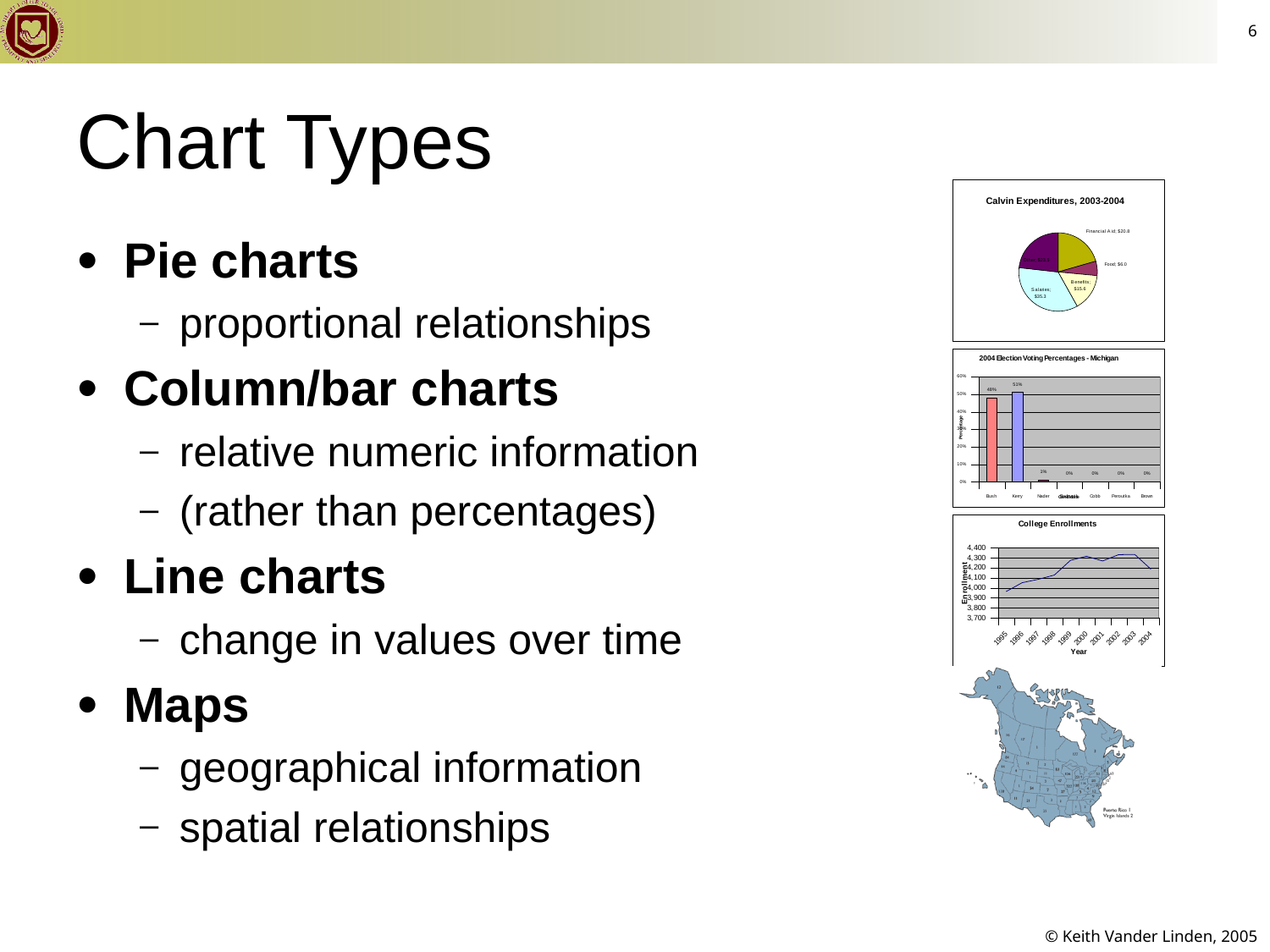
In the 2004 Election Voting Percentages - Michigan chart, what percentage is shown for Bush? 48% In the 2004 Election Voting Percentages - Michigan chart, what is the difference between Kerry's and Bush's percentages? 3% In the Calvin Expenditures, 2003-2004 pie chart, what is the value shown for Financial Aid? $20.8 What kind of chart is the 2004 Election Voting Percentages - Michigan chart? bar chart In the Calvin Expenditures, 2003-2004 pie chart, what is the value shown for Benefits? $15.6 In the College Enrollments chart, how many years are plotted on the x axis? 10 In the 2004 Election Voting Percentages - Michigan chart, what percentage is shown for Kerry? 51% In the Calvin Expenditures, 2003-2004 pie chart, what is the value shown for Food? $6.0 In the Calvin Expenditures, 2003-2004 pie chart, what is the value shown for Salaries? $35.3 In the Calvin Expenditures, 2003-2004 pie chart, how much larger is the Salaries value than the Financial Aid value? $14.5 In the College Enrollments chart, is the enrollment value for 1995 greater or less than 4,000? less In the 2004 Election Voting Percentages - Michigan chart, which candidate has the highest percentage? Kerry